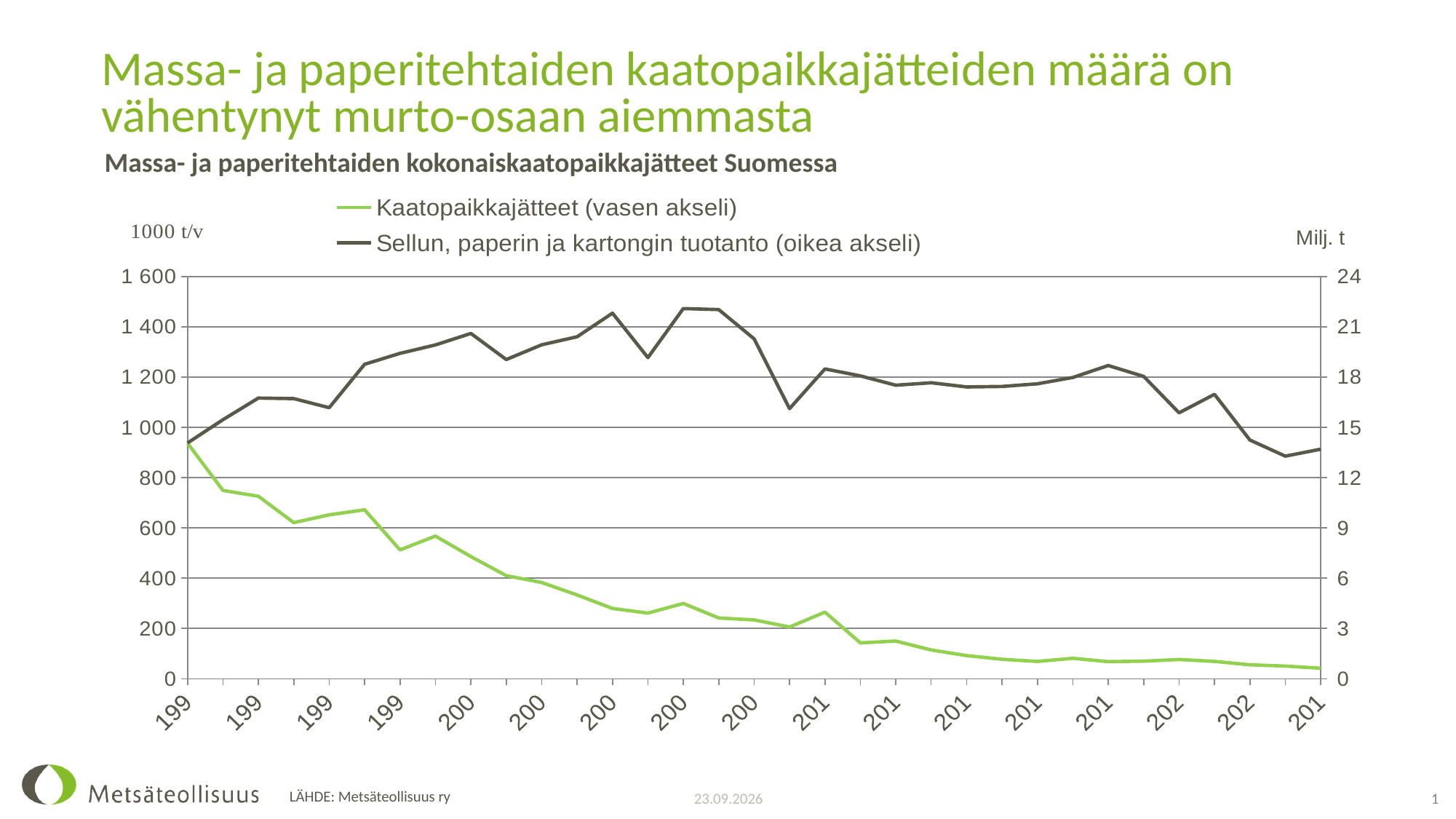
What kind of chart is shown on the slide? line chart What unit is shown for the left axis? 1000 t/v What is the title of the chart? Massa- ja paperitehtaiden kokonaiskaatopaikkajätteet Suomessa At the right end of the chart, is the Kaatopaikkajätteet (vasen akseli) value greater or less than 200? less What is the highest tick value shown on the left axis? 1 600 At the left end of the chart, is the Kaatopaikkajätteet (vasen akseli) value greater or less than 800? greater Does the Kaatopaikkajätteet (vasen akseli) series rise or fall overall along the x axis? fall At the right end of the chart, is the Sellun, paperin ja kartongin tuotanto (oikea akseli) value greater or less than 18 on the right axis? less How many series does the chart legend list? 2